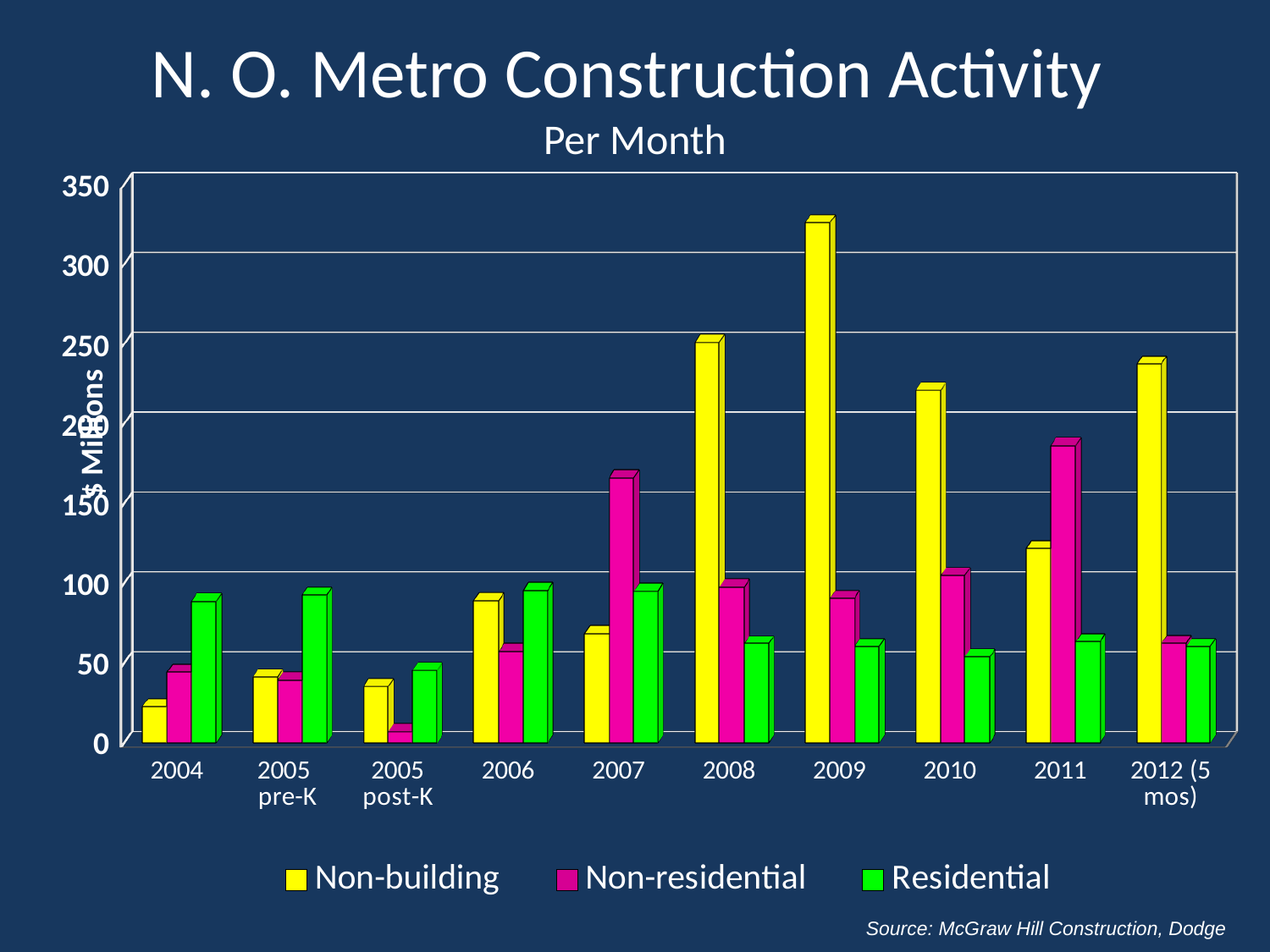
In which year is the Non-building value highest? 2009 Is the Residential value for 2009 greater or less than 100? less Is the Non-building value for 2008 greater or less than 200? greater What kind of chart is shown on the slide? bar chart In 2007, which is larger: Non-building or Non-residential? Non-residential How many categories are shown along the x axis? 10 In 2004, which is larger: Residential or Non-building? Residential How many series does the legend list? 3 In which category is the Non-residential value lowest? 2005 post-K What is the label on the vertical axis? $ Millions Is the Non-building value for 2009 greater or less than 300? greater In which category is the Non-residential value highest? 2011